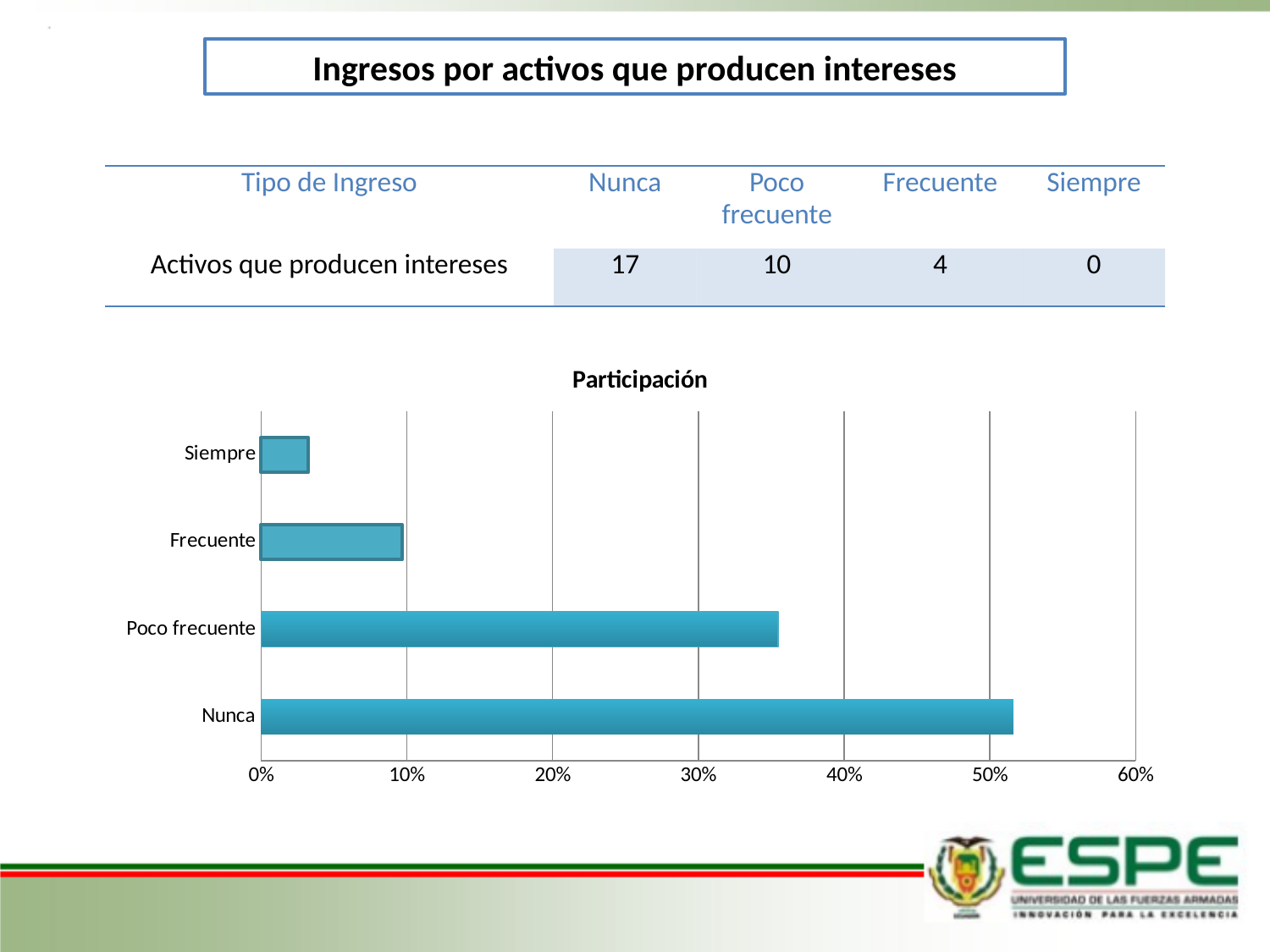
What kind of chart is shown on the slide? bar chart How many categories are plotted in the chart? 4 What is the highest value shown on the horizontal axis of the chart? 60% Is the value for Poco frecuente greater or less than 30%? greater Is the value for Poco frecuente greater or less than 40%? less Which category has the shortest bar in the chart? Siempre What is the title of the chart? Participación Is the value for Siempre greater or less than 10%? less Which is larger, the value for Poco frecuente or the value for Frecuente? Poco frecuente Which category has the longest bar in the chart? Nunca Which is larger, the value for Frecuente or the value for Siempre? Frecuente